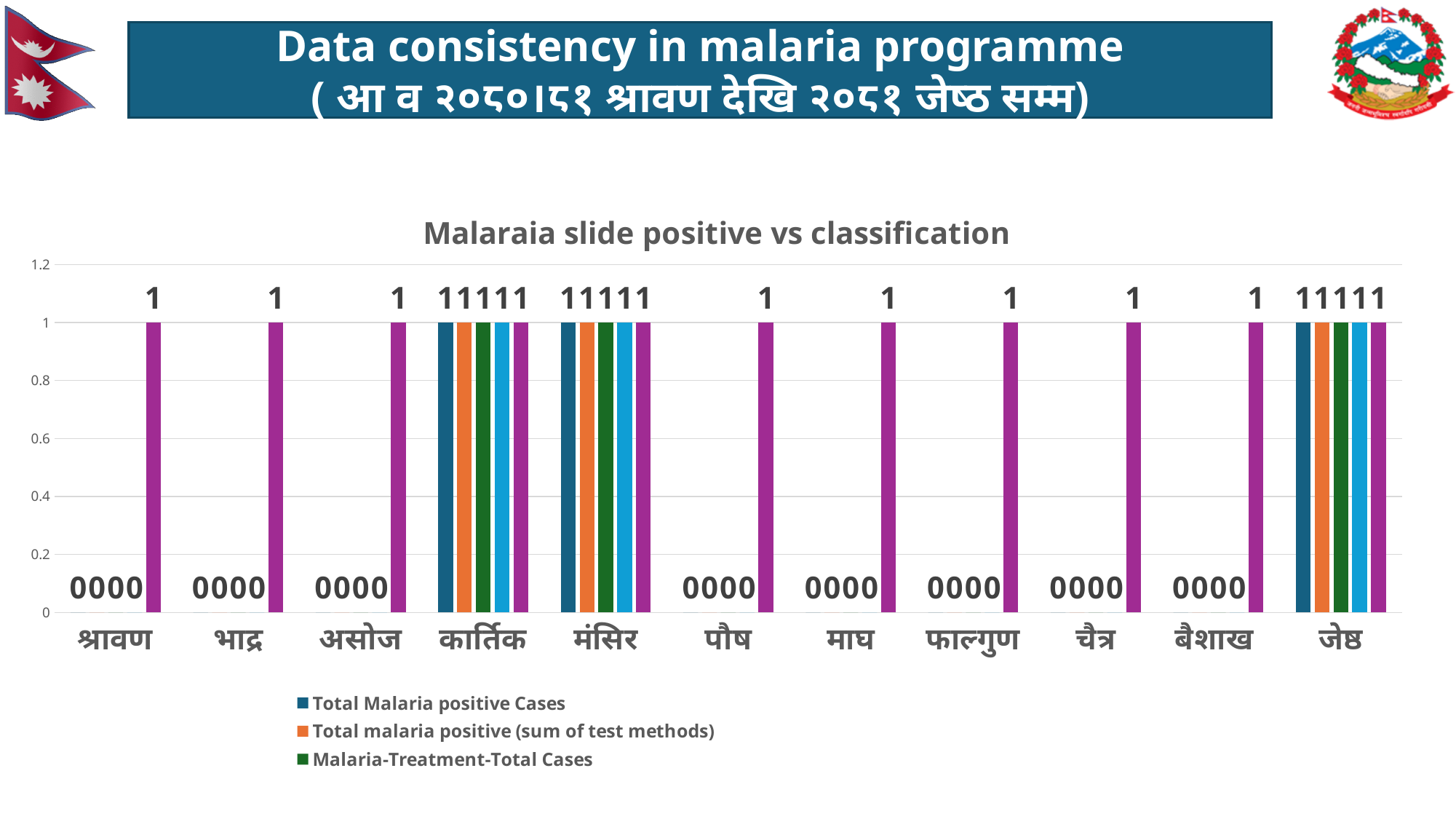
Which is larger: Total Malaria positive Cases for कार्तिक or for भाद्र? कार्तिक What is the value of Malaria-Treatment-Total Cases for मंसिर? 1 What is the highest value shown on the chart's y axis? 1.2 What is the value of Total malaria positive (sum of test methods) for पौष? 0 What is the title of the chart? Malaraia slide positive vs classification Which legend entry is shown in orange? Total malaria positive (sum of test methods) How many series does the chart's legend list? 3 What is the value of Total Malaria positive Cases for श्रावण? 0 What kind of chart is shown on the slide? bar chart What is the difference between Total Malaria positive Cases for जेष्ठ and for बैशाख? 1 How many categories (months) are shown on the x axis of the chart? 11 What is the value of Total Malaria positive Cases for कार्तिक? 1